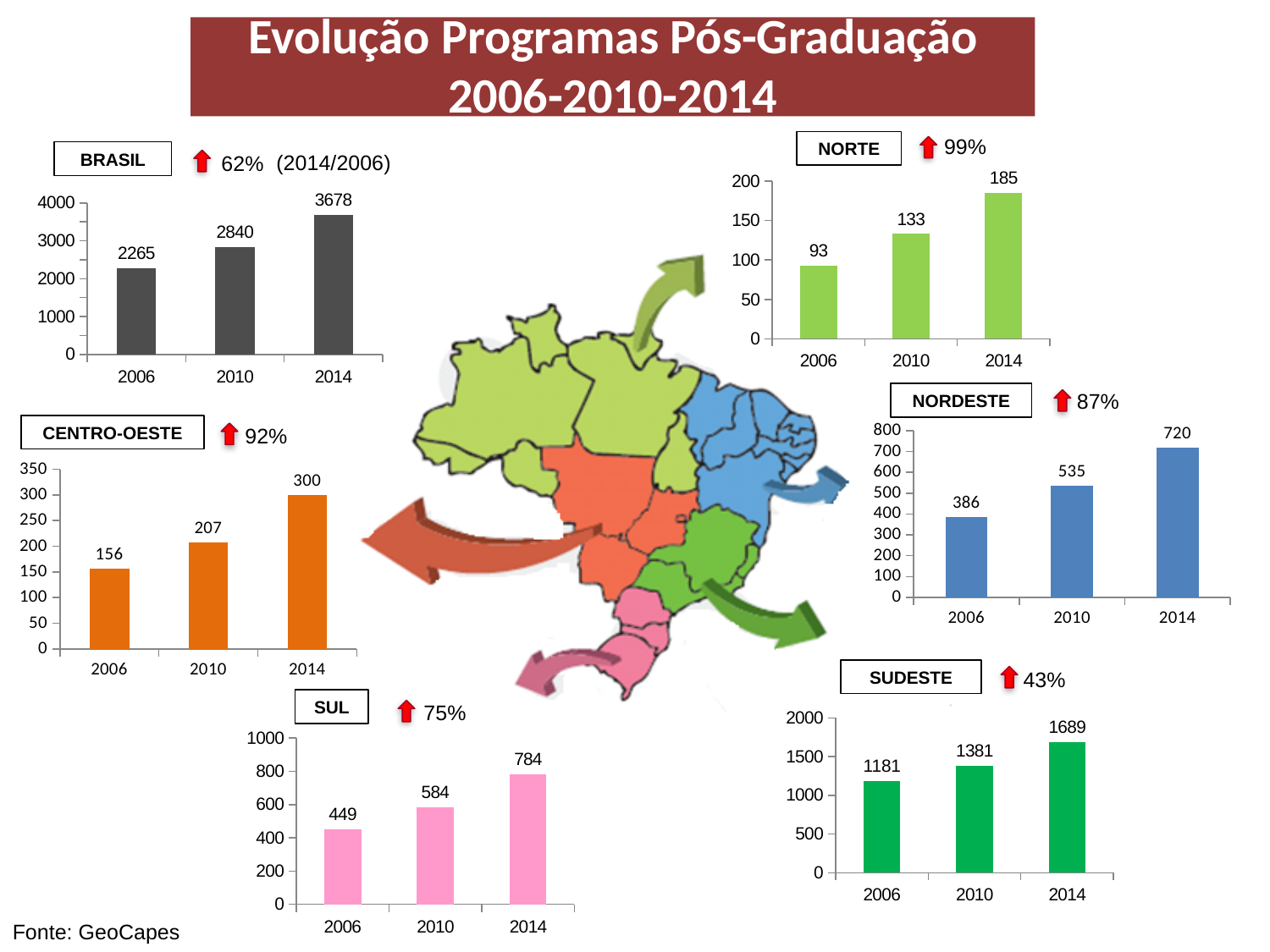
Which is larger: the 2014 value in the NORDESTE chart or the 2014 value in the SUL chart? SUL (784) In the SUDESTE chart, is the value for 2010 greater or less than 1500? less How many years are plotted in the CENTRO-OESTE chart? 3 In the NORDESTE chart, what is the value for 2010? 535 In the NORDESTE chart, do the values rise or fall from 2006 to 2014? rise In the NORTE chart, what is the value for 2006? 93 What kind of chart is the NORTE chart? bar chart In the SUL chart, what is the difference between the 2014 and 2006 values? 335 In the BRASIL chart, what is the value for 2014? 3678 In the BRASIL chart, what is the difference between the 2010 and 2006 values? 575 In the SUDESTE chart, which year has the highest value? 2014 In the CENTRO-OESTE chart, which year has the lowest value? 2006